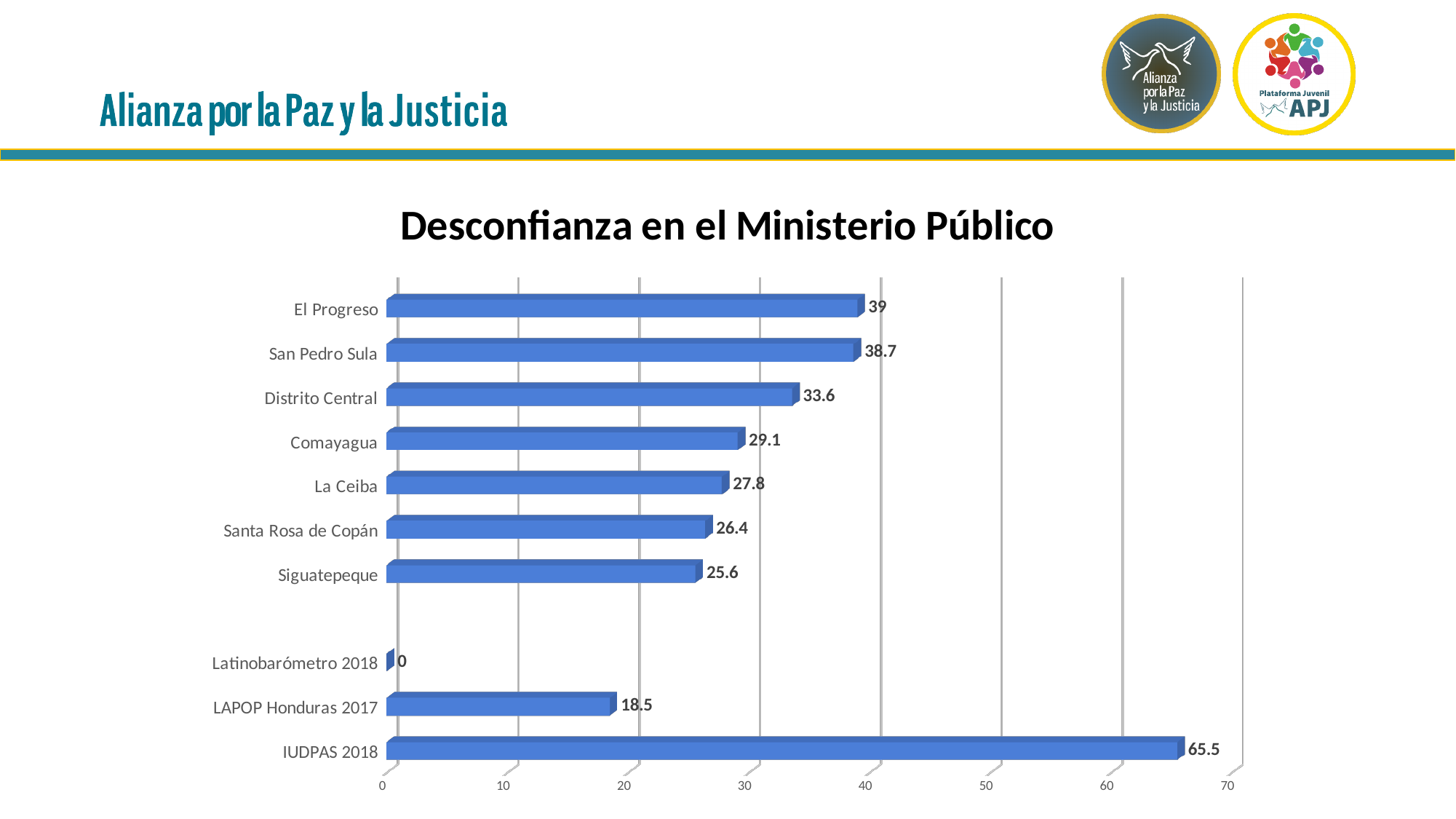
What kind of chart is shown on the slide? Bar chart What is the value for Latinobarómetro 2018? 0 What is the difference between the values for IUDPAS 2018 and LAPOP Honduras 2017? 47 What is the value for LAPOP Honduras 2017? 18.5 Which has a larger value, San Pedro Sula or La Ceiba? San Pedro Sula What is the title of the chart? Desconfianza en el Ministerio Público Which category has the highest value? IUDPAS 2018 Which category has the lowest value? Latinobarómetro 2018 What is the difference between the values for Comayagua and Siguatepeque? 3.5 What is the value for Distrito Central? 33.6 What is the value for El Progreso? 39 How many categories are shown on the chart? 10